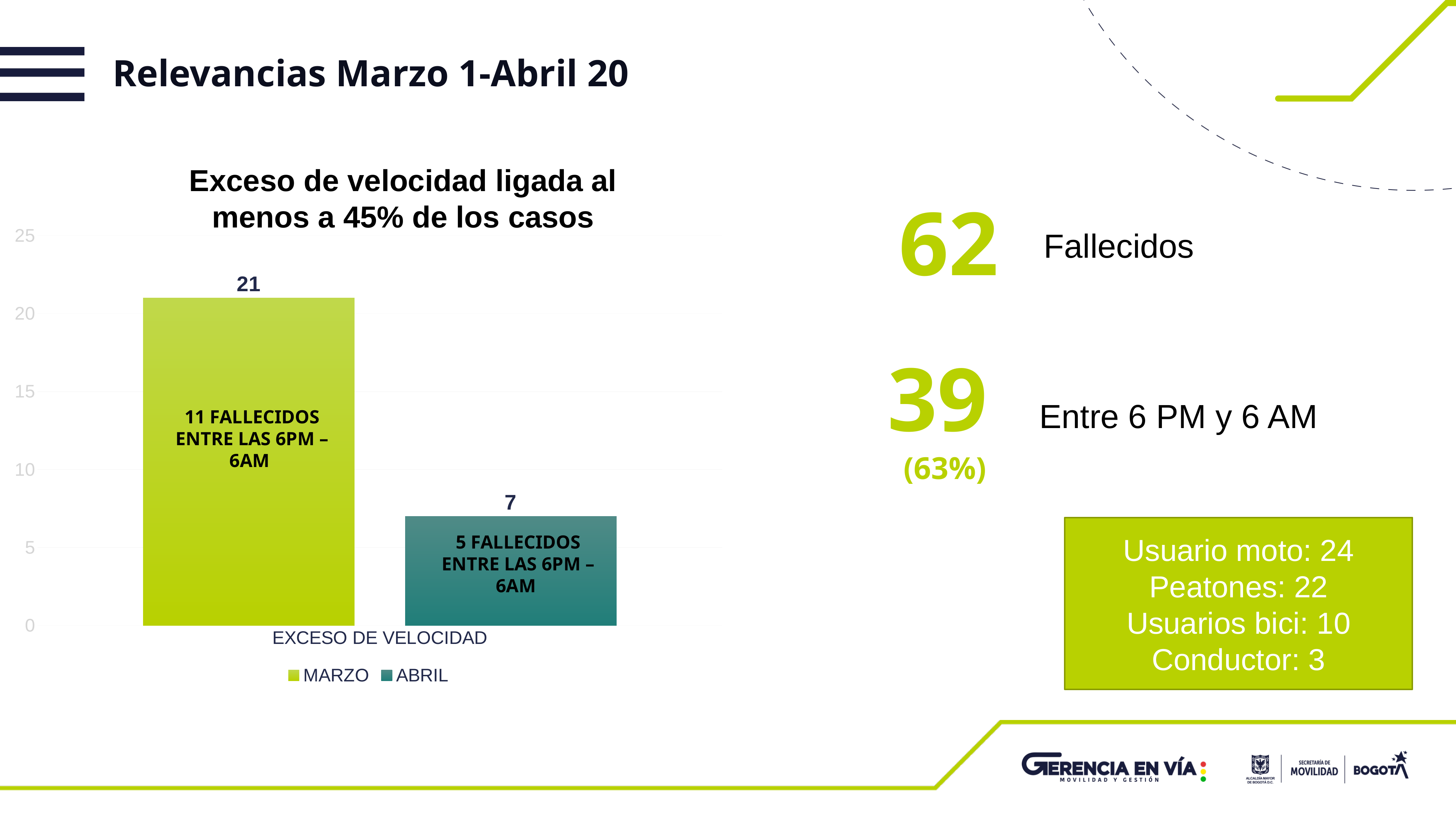
Which series has the higher value, MARZO or ABRIL? MARZO How many series does the legend list? 2 Is the value for MARZO greater or less than 20? greater What is the total of the MARZO and ABRIL values combined? 28 What is the title of the chart? Exceso de velocidad ligada al menos a 45% de los casos Is the value for ABRIL greater or less than 10? less What kind of chart is shown on the slide? bar chart What is the category label on the x axis of the chart? EXCESO DE VELOCIDAD What is the value for ABRIL in the chart? 7 What is the value for MARZO in the chart? 21 What is the difference between the MARZO and ABRIL values? 14 Which series has the lower value in the chart? ABRIL